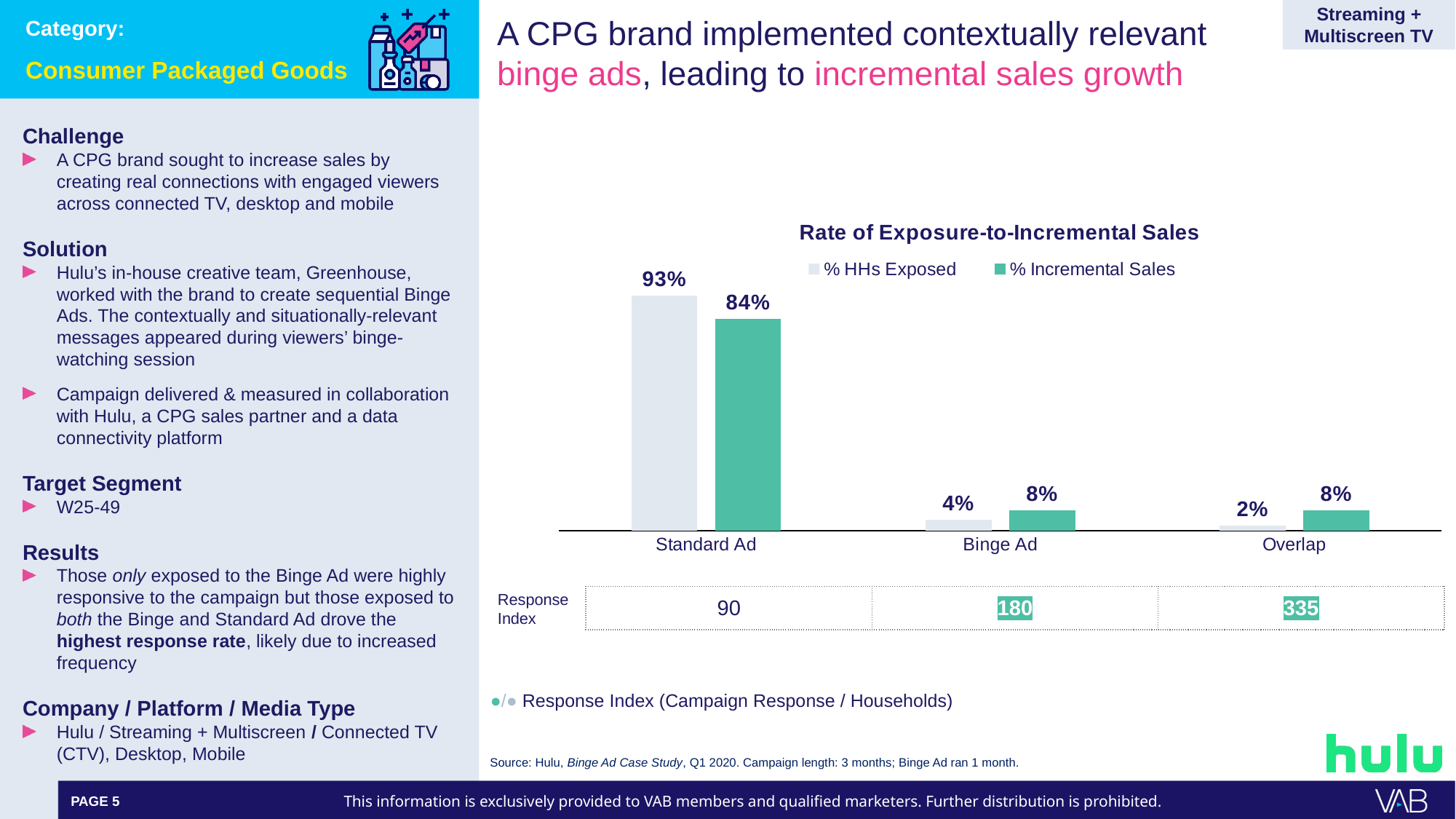
What is the title of the chart? Rate of Exposure-to-Incremental Sales What kind of chart is shown on the slide? Bar chart What is the % HHs Exposed value for Standard Ad? 93% What is the % Incremental Sales value for Standard Ad? 84% Which category has the highest % HHs Exposed? Standard Ad How many categories are shown on the x axis of the chart? 3 What is the difference between % HHs Exposed and % Incremental Sales for Standard Ad? 9% What is the % HHs Exposed value for Overlap? 2% Which category has the lowest % HHs Exposed? Overlap How many series does the chart legend list? 2 What is the % Incremental Sales value for Binge Ad? 8% For Binge Ad, which is larger: % HHs Exposed or % Incremental Sales? % Incremental Sales